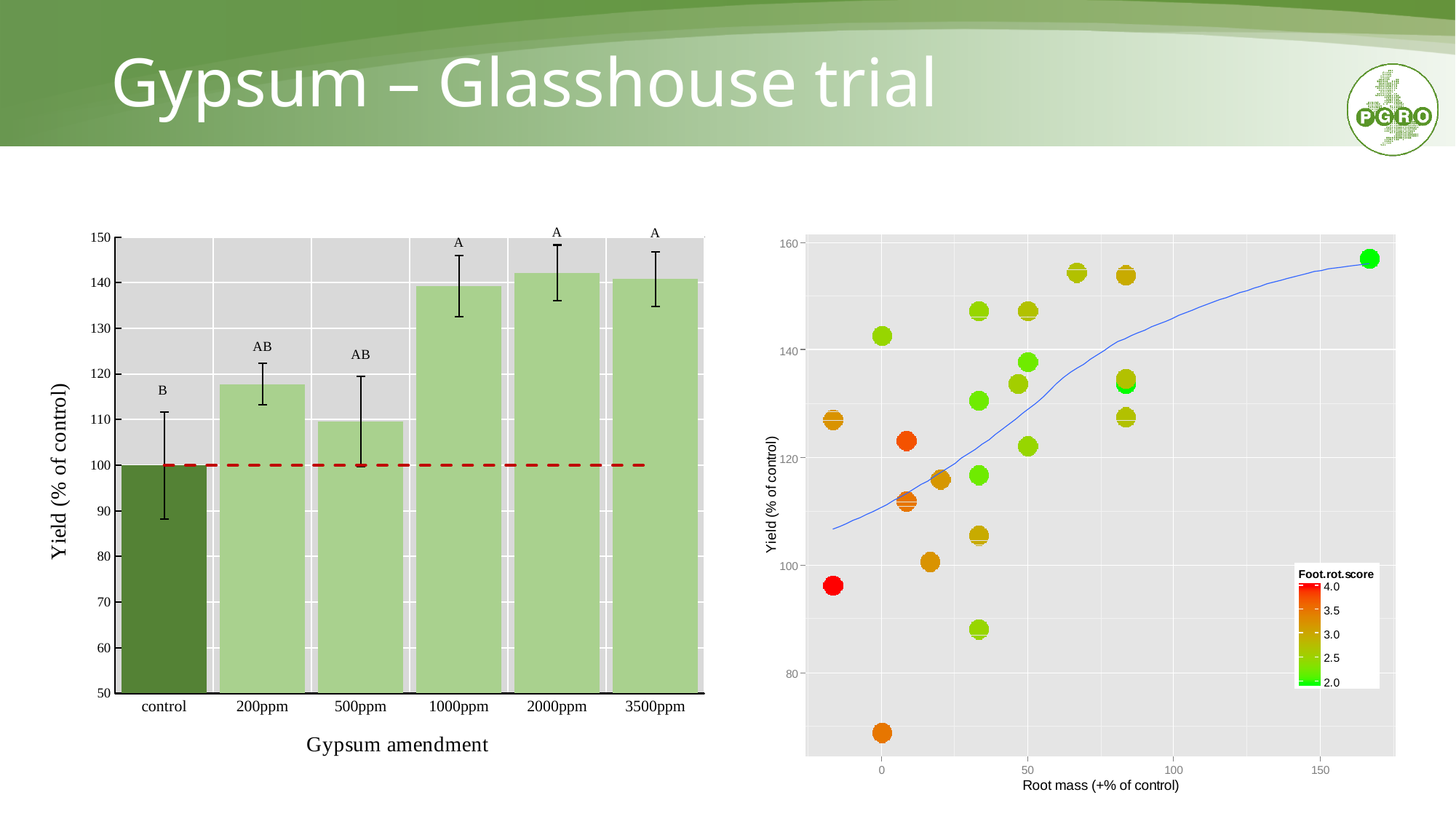
On the left bar chart, is the yield for 200ppm greater or less than 110? greater On the left bar chart, what statistical letter is printed above the control bar? B On the left bar chart, is the yield for 1000ppm greater or less than 130? greater On the right scatter plot, is the yield of the point with the highest root mass greater or less than 140? greater What kind of chart is the left chart? bar chart On the right scatter plot, what is the label of the x axis? Root mass (+% of control) On the left bar chart, which gypsum amendment has the lowest yield? control What kind of chart is the right chart? scatter plot On the left bar chart, what is the yield value for the control? 100 On the left bar chart, which has the higher yield, 500ppm or 1000ppm? 1000ppm On the left bar chart, how many gypsum amendment categories are shown? 6